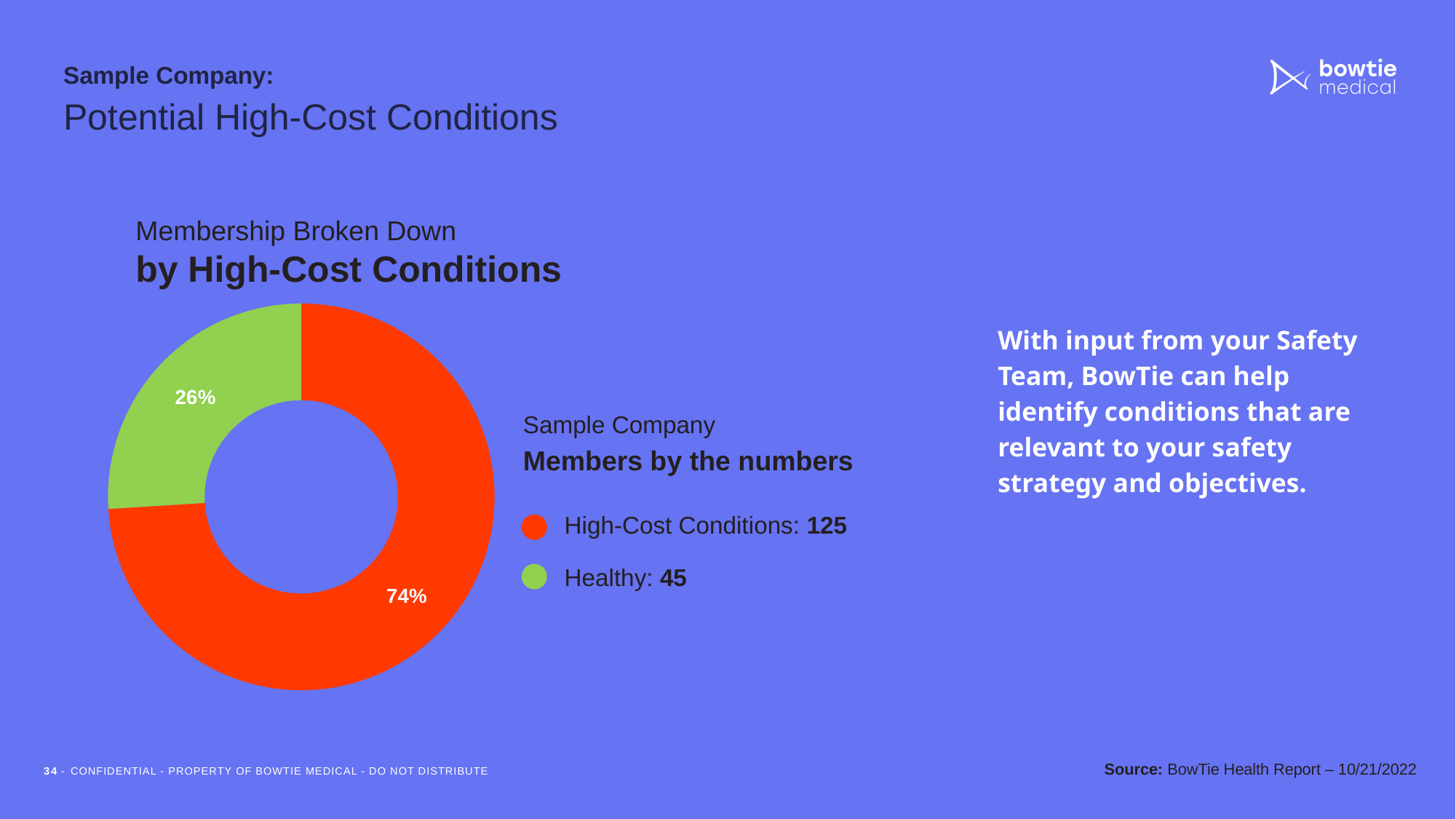
Which category has the smaller share of the donut chart? Healthy What colour represents the Healthy category in the chart? Green How many members are listed under High-Cost Conditions? 125 What is the difference in member count between High-Cost Conditions and Healthy? 80 How many members are listed under Healthy? 45 What is the title of the chart? Membership Broken Down by High-Cost Conditions What kind of chart is shown on the slide? Donut (pie) chart Which category has the larger share of the donut chart? High-Cost Conditions What is the total number of members across both categories? 170 What share of the donut chart is labelled for High-Cost Conditions? 74% What share of the donut chart is labelled for Healthy? 26% How many categories does the donut chart show? 2